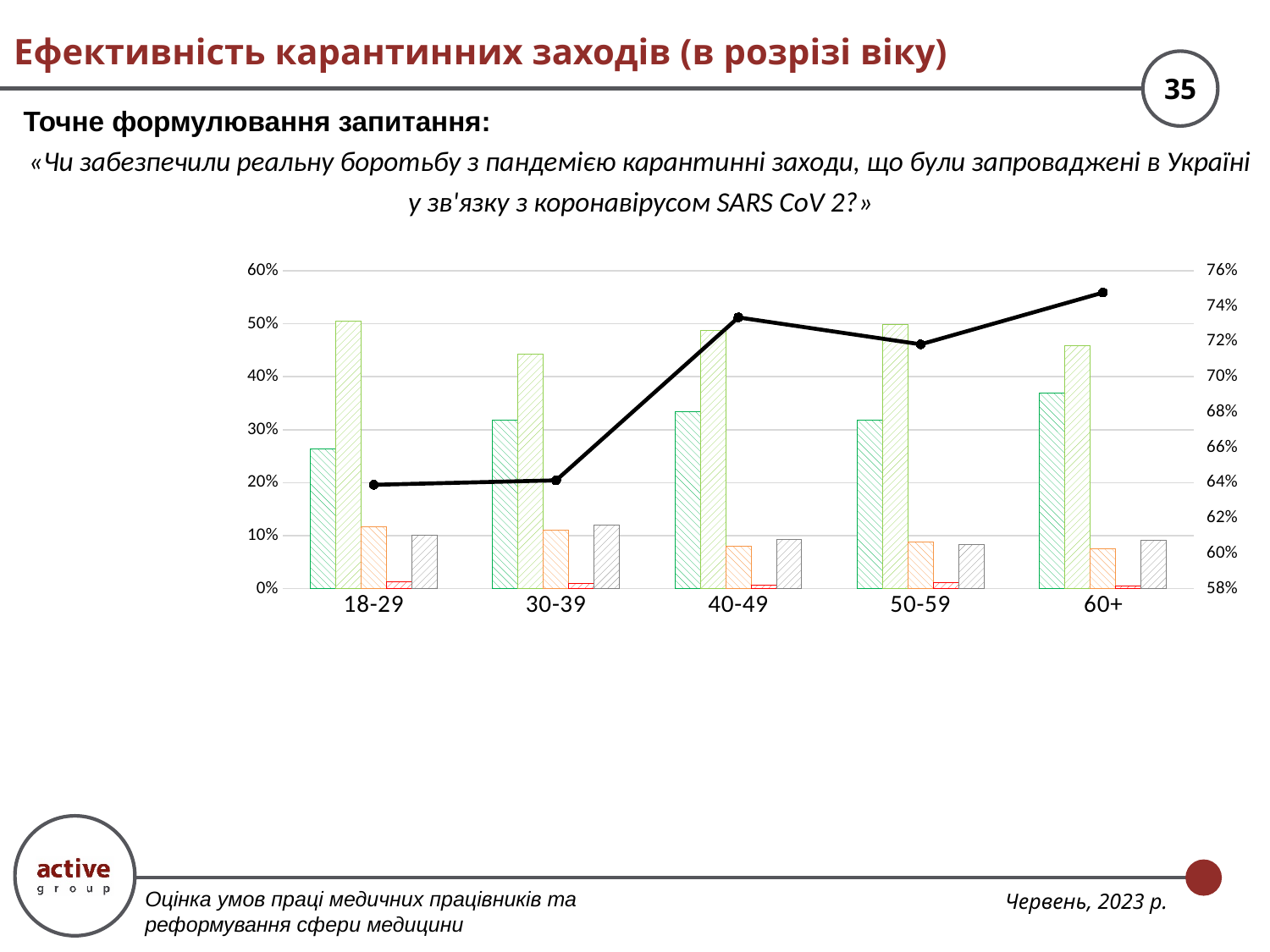
Is the value of the black line for the 60+ age group greater or less than 70%? greater Is the tallest bar in the 18-29 age group greater or less than 40% on the left axis? greater How many bars are plotted for each age group in the chart? 5 Is the value of the black line for the 40-49 age group greater or less than 72%? greater How many age groups are shown on the x axis of the chart? 5 What is the highest value shown on the right-hand axis of the chart? 76% Does the black line generally rise or fall from the 18-29 group to the 60+ group? rise Which age group has the highest value on the black line? 60+ Is the value of the black line for the 40-49 age group larger or smaller than for the 30-39 age group? larger What kind of chart is shown on the slide? a combined bar and line chart